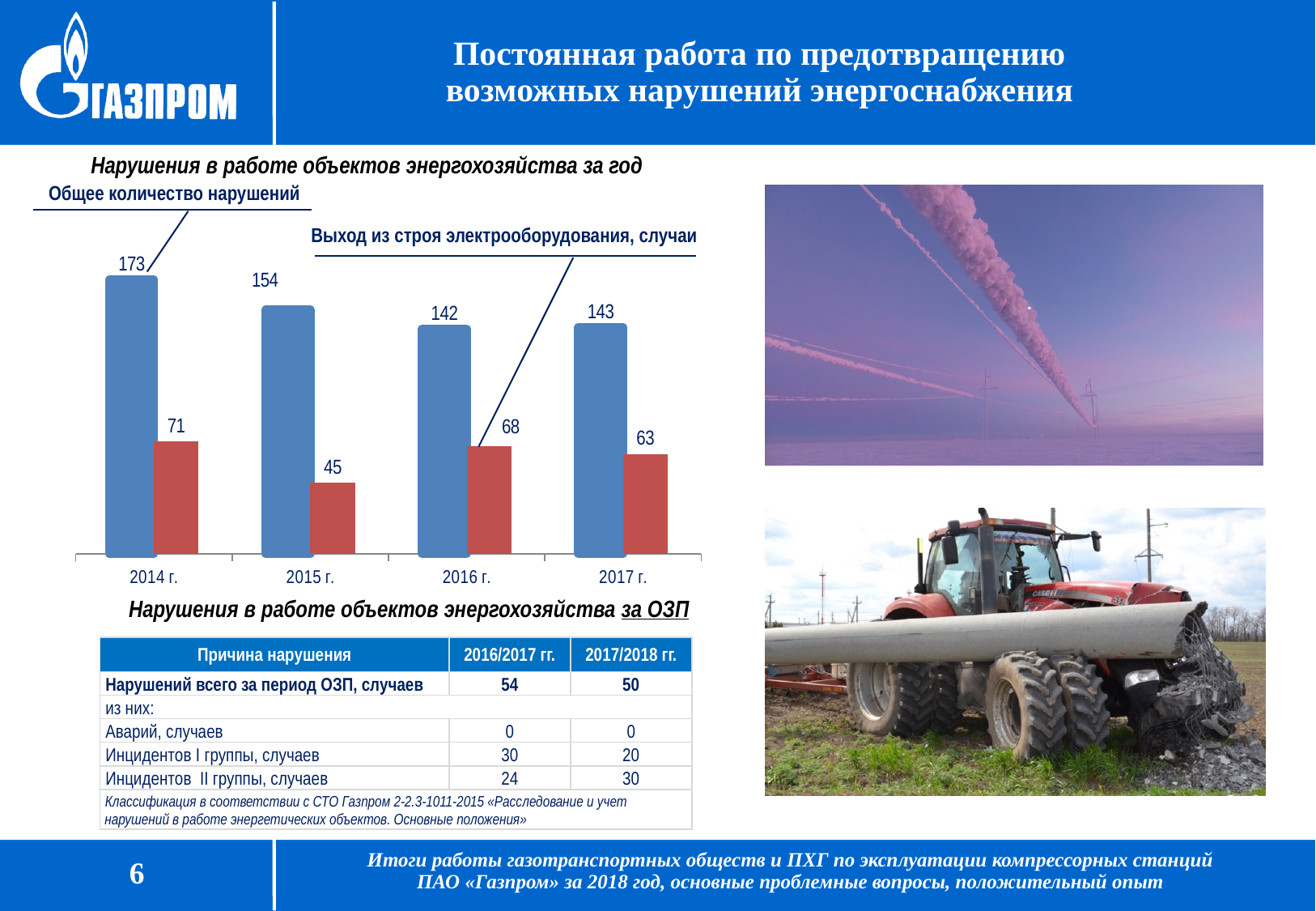
How many years are shown on the x axis of the chart? 4 What is the value of "Общее количество нарушений" for 2017 г.? 143 Which is larger: "Выход из строя электрооборудования, случаи" in 2014 г. or in 2016 г.? 2014 г. What is the difference between "Общее количество нарушений" in 2014 г. and 2015 г.? 19 What is the value of "Выход из строя электрооборудования, случаи" for 2015 г.? 45 In which year is "Общее количество нарушений" the highest? 2014 г. How many data series does the chart show? 2 What is the value of "Общее количество нарушений" for 2014 г.? 173 What is the difference between "Выход из строя электрооборудования, случаи" in 2016 г. and 2017 г.? 5 In which year is "Выход из строя электрооборудования, случаи" the lowest? 2015 г. What type of chart is shown under the title "Нарушения в работе объектов энергохозяйства за год"? Bar chart What colour are the bars for "Выход из строя электрооборудования, случаи"? Red